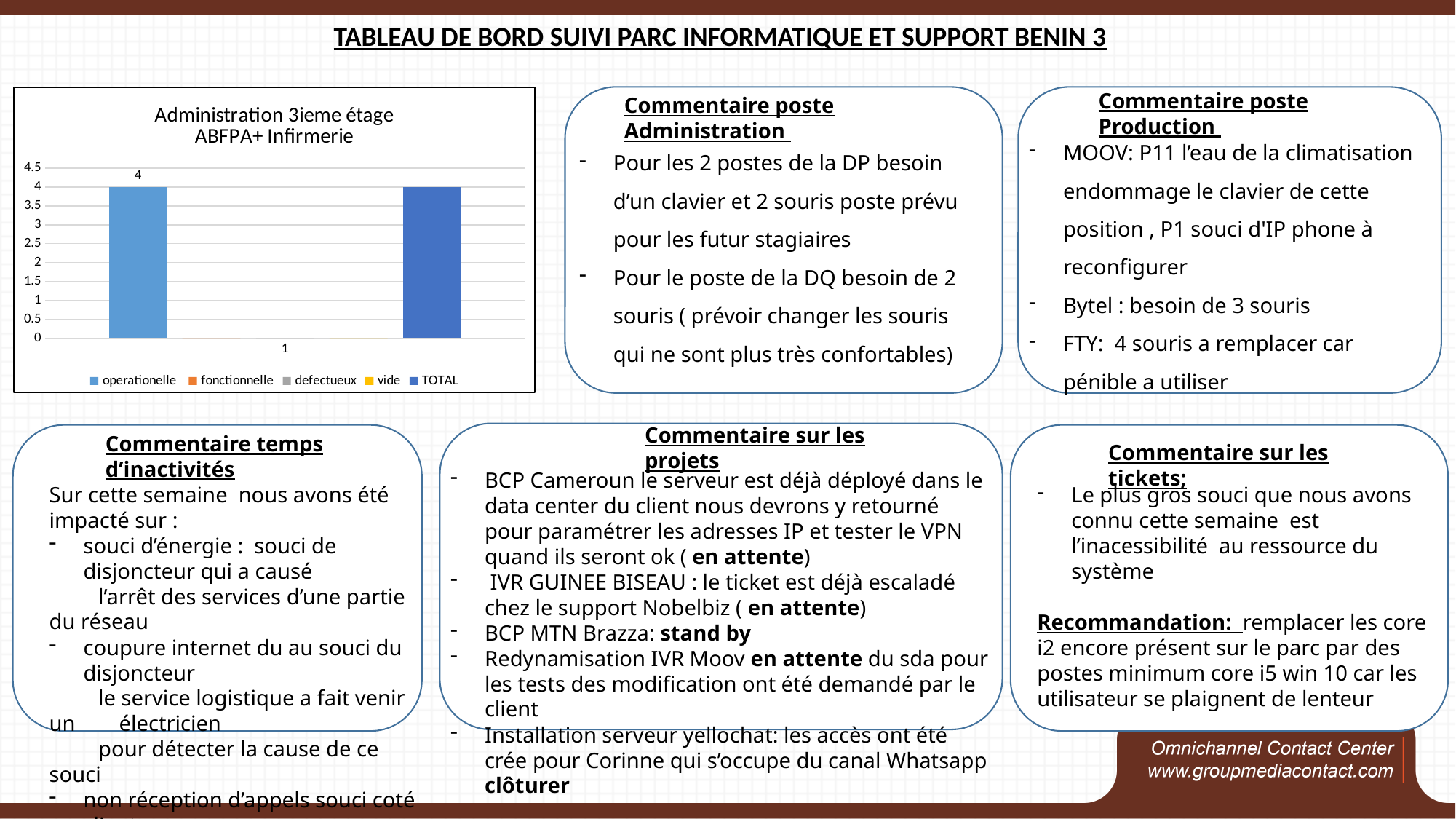
What is the value of the TOTAL bar? 4 Is the value for TOTAL greater or less than 3? greater What is the highest value shown on the chart's vertical axis? 4.5 What kind of chart is shown on the slide? bar chart Is the value for operationelle greater or less than 2? greater Which is larger, the operationelle value or the fonctionnelle value? operationelle Which series is listed first in the chart legend? operationelle What is the title of the chart? Administration 3ieme étage ABFPA+ Infirmerie How many series does the chart legend list? 5 How many categories are shown on the x axis of the chart? 1 What is the value of the operationelle bar? 4